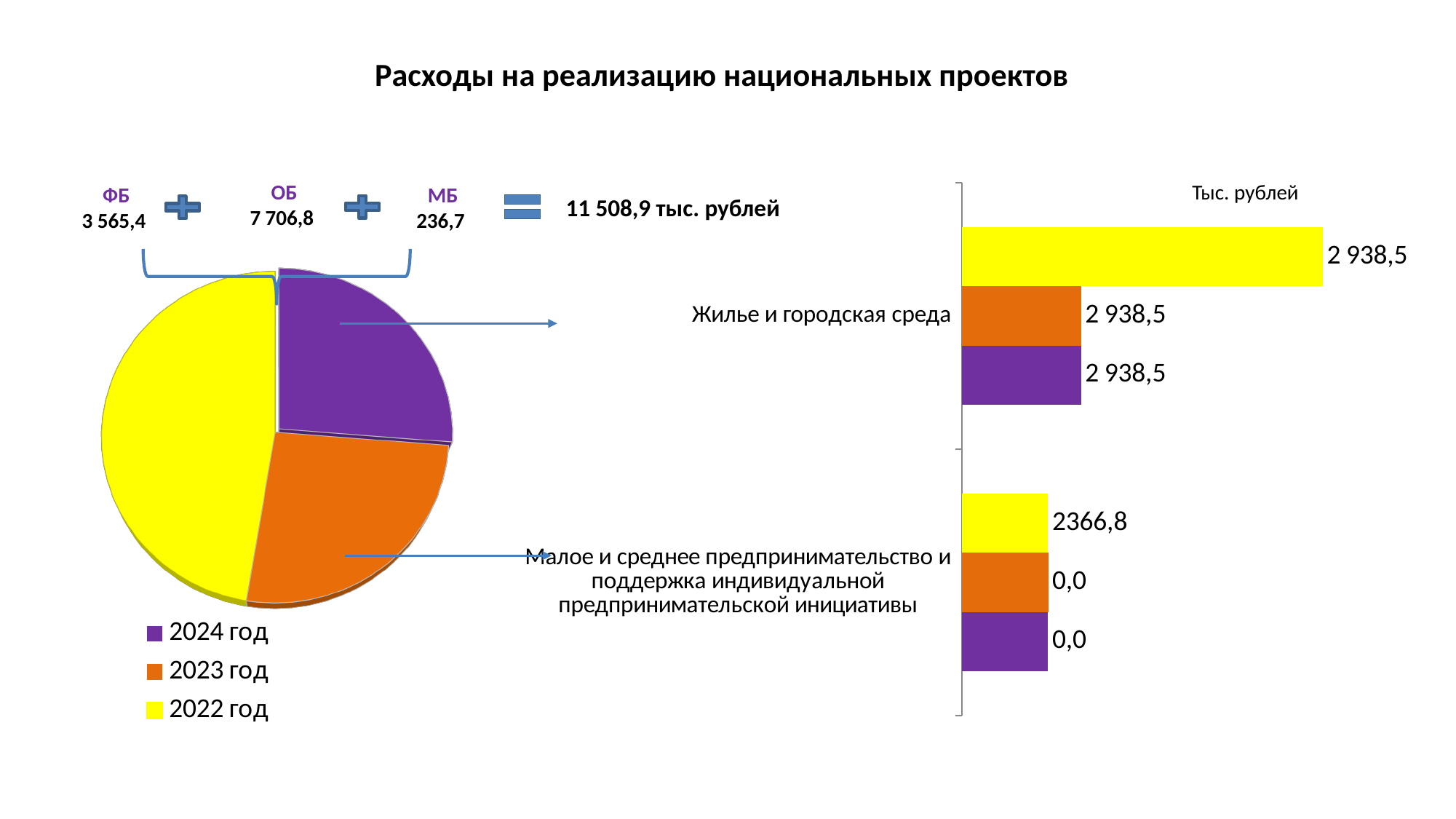
In the bar chart on the right, what is the value of the purple (2024 год) bar for Жилье и городская среда? 2 938,5 How many categories does the bar chart on the right show? 2 In the bar chart on the right, which category has the larger 2022 год value: Жилье и городская среда or Малое и среднее предпринимательство? Жилье и городская среда What kind of chart is the chart on the right of the slide? bar chart What kind of chart is the chart on the left of the slide? pie chart What unit label is shown at the top of the bar chart on the right? Тыс. рублей In the bar chart on the right, what is the value of the yellow (2022 год) bar for Малое и среднее предпринимательство и поддержка индивидуальной предпринимательской инициативы? 2366,8 In the pie chart on the left, which year has the largest slice? 2022 год How many entries does the legend of the pie chart on the left list? 3 In the bar chart on the right, what is the difference between the 2022 год values for Жилье и городская среда and Малое и среднее предпринимательство? 571,7 In the bar chart on the right, what is the value of the orange (2023 год) bar for Малое и среднее предпринимательство и поддержка индивидуальной предпринимательской инициативы? 0,0 In the bar chart on the right, what is the value of the yellow (2022 год) bar for Жилье и городская среда? 2 938,5